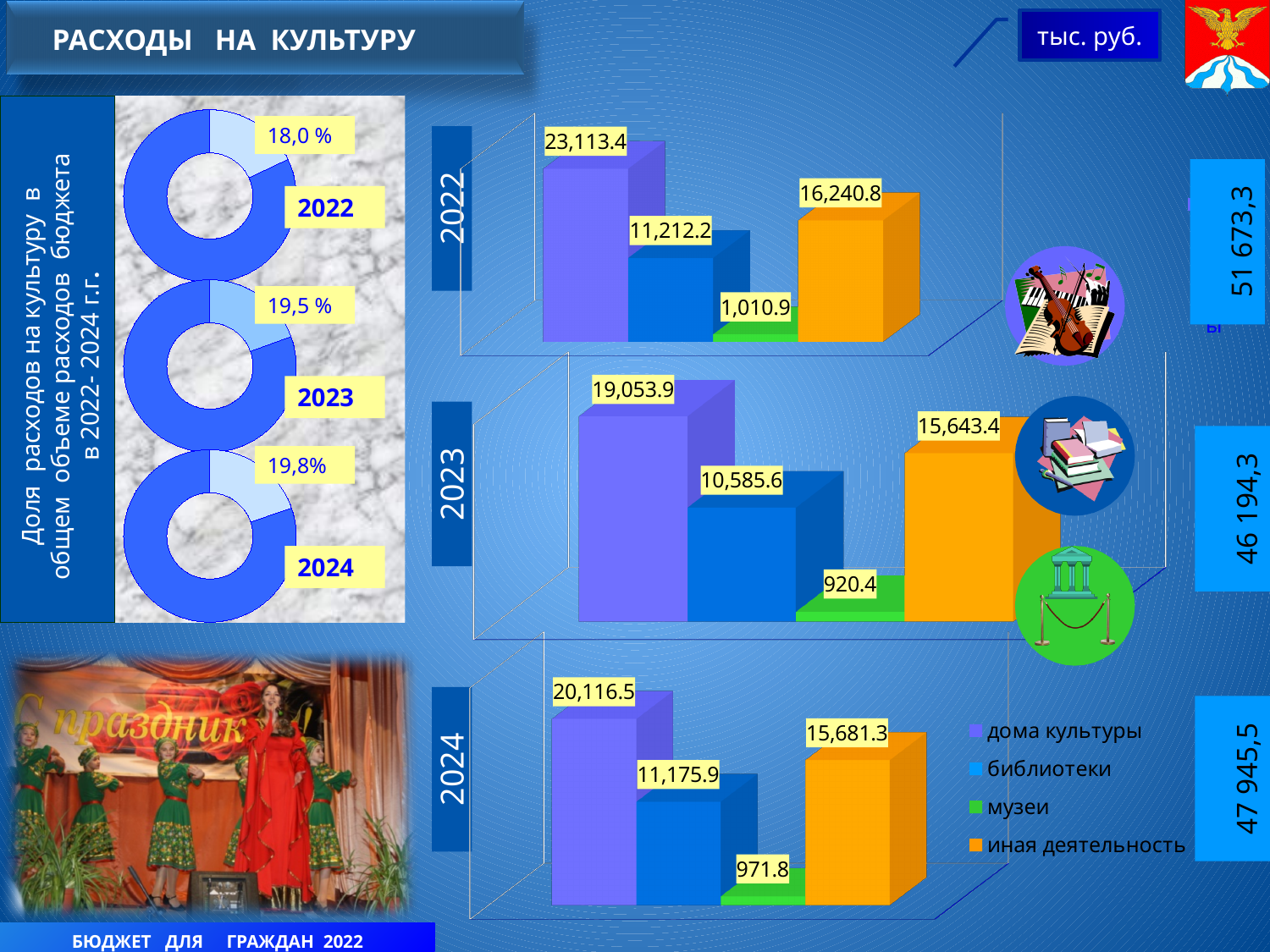
In the 2023 bar chart, which is larger: библиотеки or иная деятельность? иная деятельность Across the donut charts for 2022, 2023 and 2024, does the share of culture expenditure rise or fall? rise In the 2022 bar chart, what is the difference between дома культуры and иная деятельность? 6,872.6 In the 2023 bar chart, what is the value for иная деятельность? 15,643.4 How many categories does the legend of the bar charts list? 4 In the 2022 bar chart, which category has the lowest value? музеи In the 2022 bar chart, what is the value for дома культуры? 23,113.4 In the 2024 bar chart, what is the value for музеи? 971.8 In the donut chart for 2023, what share of total budget expenditure goes to culture? 19,5 % What type of chart is used to show the 2022, 2023 and 2024 expenditure breakdowns? bar chart In the 2024 bar chart, which category has the highest value? дома культуры In the 2023 bar chart, what is the value for библиотеки? 10,585.6